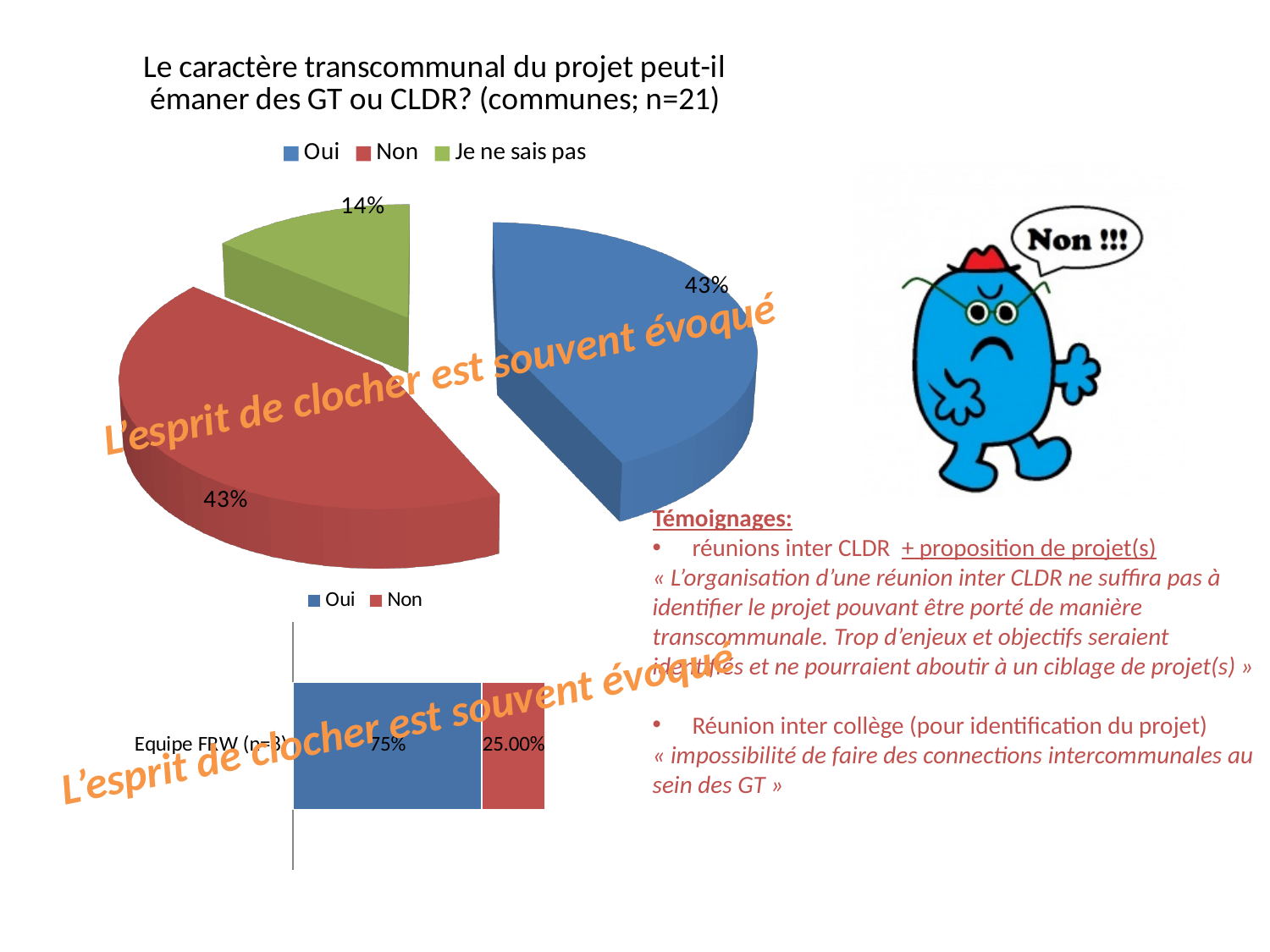
What kind of chart is the bottom chart on the slide? Bar chart In the pie chart, what share of communes answered "Je ne sais pas"? 14% In the pie chart, what share of communes answered "Non"? 43% How many series does the legend of the bottom bar chart list? 2 What kind of chart is the top chart on the slide? Pie chart How many series does the legend of the pie chart list? 3 In the bottom bar chart, which is larger, "Oui" or "Non"? Oui In the pie chart, what share of communes answered "Oui"? 43% In the bottom bar chart, what is the value for "Oui"? 75% In the pie chart, which answer has the smallest share? Je ne sais pas In the pie chart, what is the difference between the "Oui" share and the "Je ne sais pas" share? 29% In the bottom bar chart, what is the value for "Non"? 25.00%